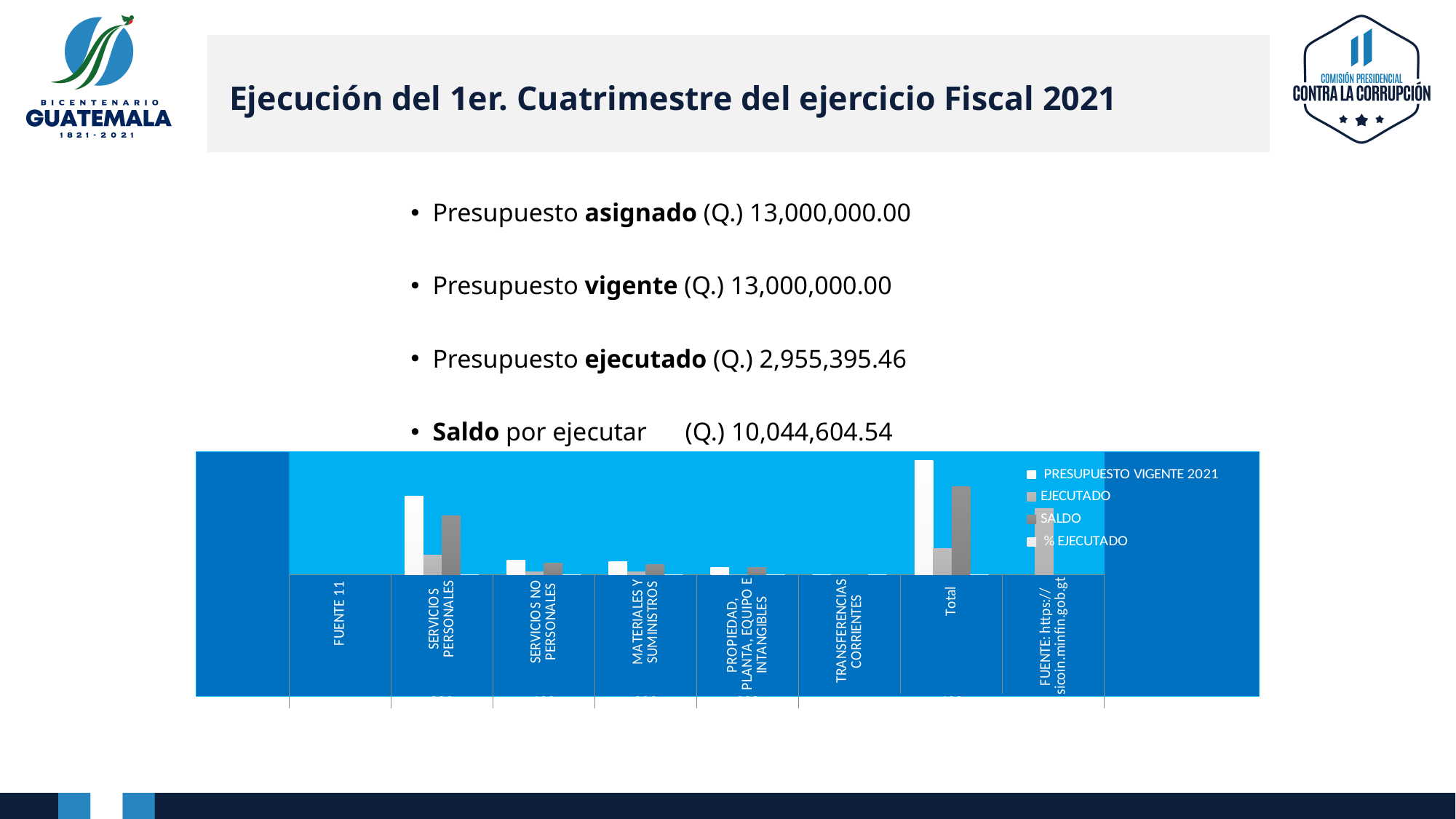
Which is larger for Total, the EJECUTADO bar or the SALDO bar? SALDO Which is larger for SERVICIOS PERSONALES, the EJECUTADO bar or the SALDO bar? SALDO Which category has the taller PRESUPUESTO VIGENTE 2021 bar, MATERIALES Y SUMINISTROS or PROPIEDAD, PLANTA, EQUIPO E INTANGIBLES? MATERIALES Y SUMINISTROS Which category has the tallest PRESUPUESTO VIGENTE 2021 bar? Total How many series does the chart legend list? 4 What kind of chart is shown on the slide? Bar chart Excluding Total, which category has the tallest PRESUPUESTO VIGENTE 2021 bar? SERVICIOS PERSONALES Which series is listed first in the chart legend? PRESUPUESTO VIGENTE 2021 Which series is listed last in the chart legend? % EJECUTADO